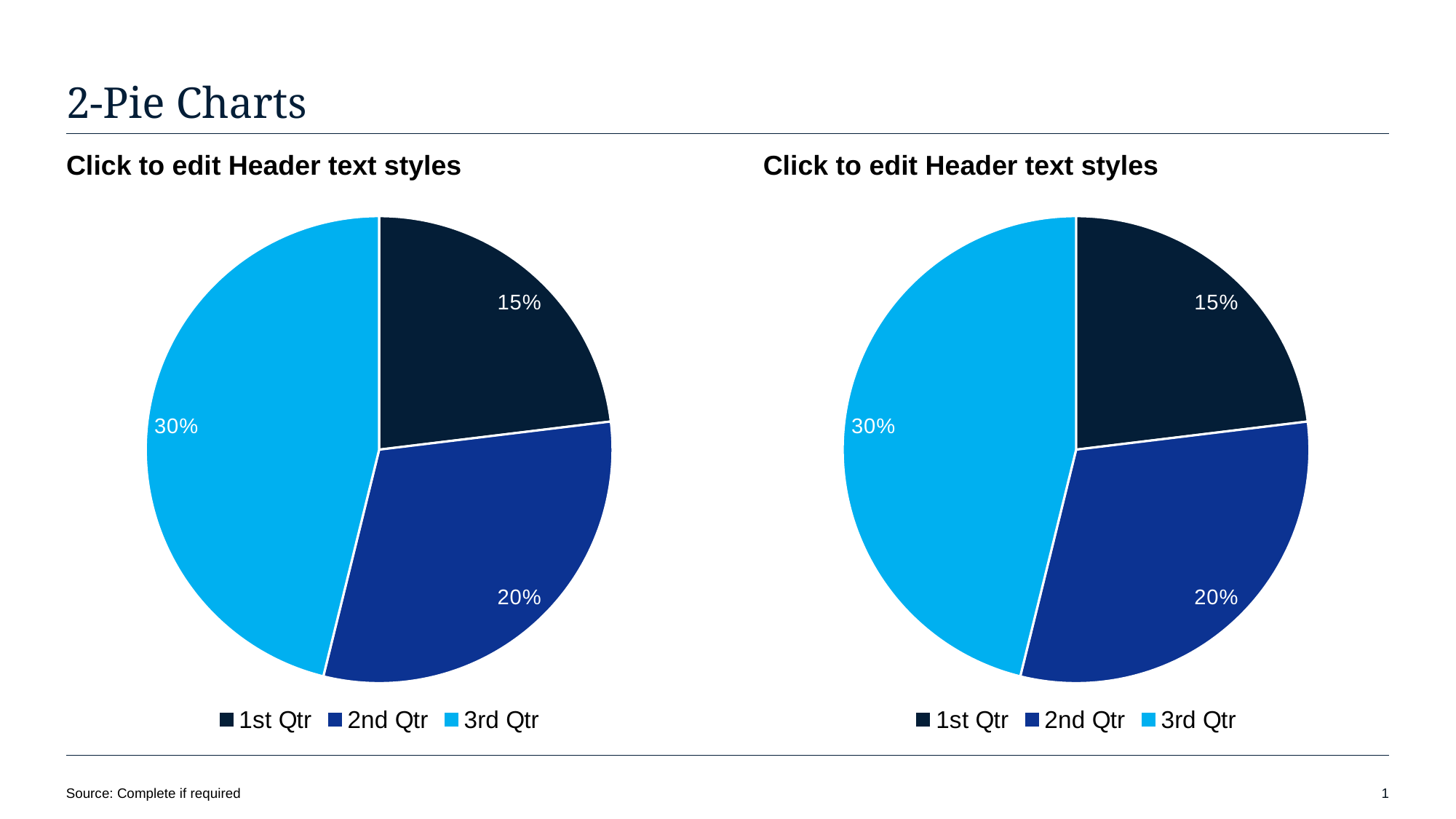
In the left pie chart, which category has the smallest slice? 1st Qtr What kind of chart is the left chart on the slide? Pie chart What is the title of the slide? 2-Pie Charts In the left pie chart, which is larger, the 2nd Qtr slice or the 1st Qtr slice? 2nd Qtr In the right pie chart, what is the value shown for 3rd Qtr? 30% In the right pie chart, what is the difference between the values for 3rd Qtr and 1st Qtr? 15% In the left pie chart, what is the value shown for 2nd Qtr? 20% How many slices does the right pie chart have? 3 In the right pie chart, which category has the largest slice? 3rd Qtr In the left pie chart, what is the value shown for 1st Qtr? 15% How many entries does the legend of the left pie chart list? 3 In the right pie chart, what share of the pie is labelled for 2nd Qtr? 20%